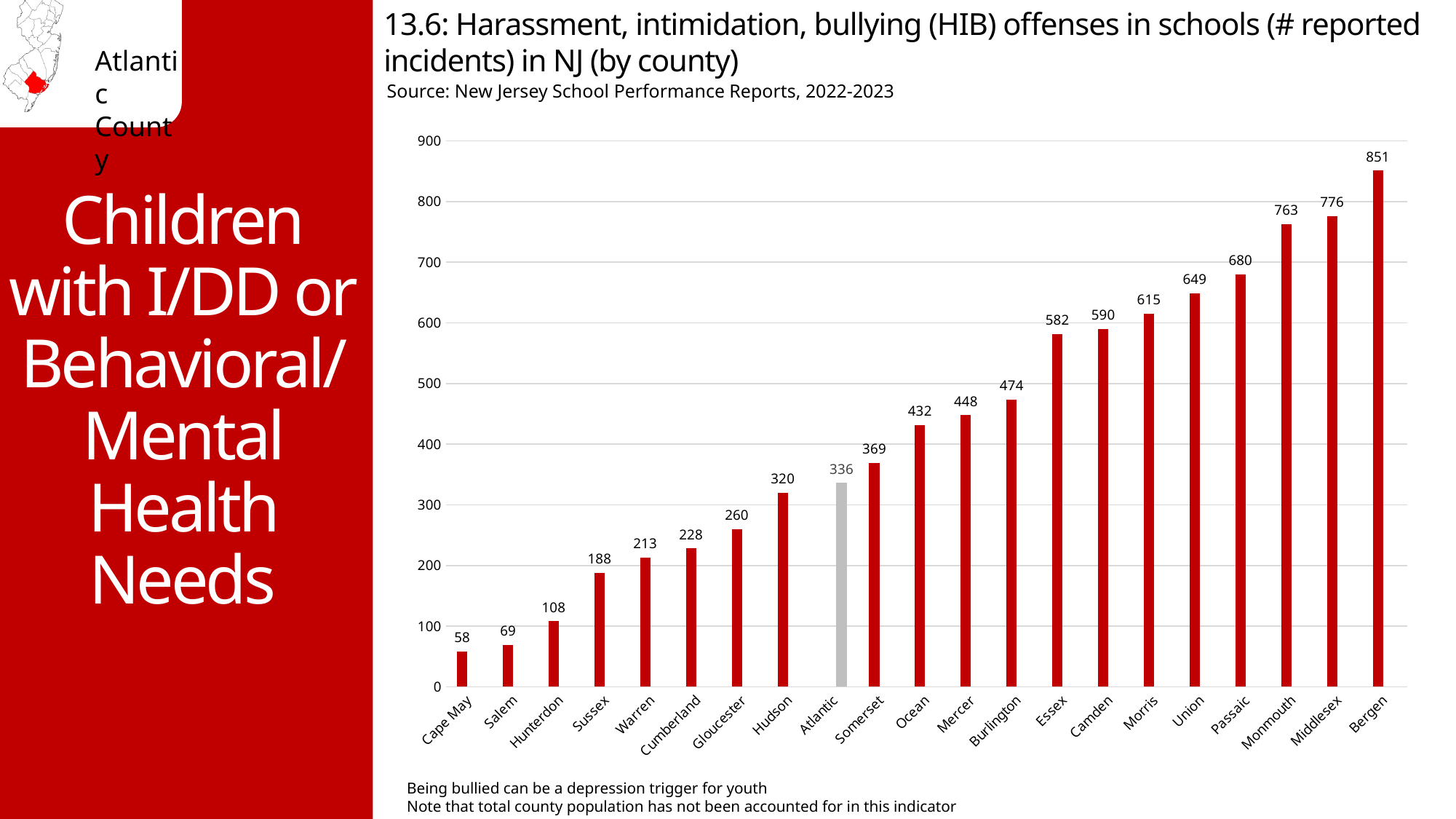
What is the number of reported HIB incidents for Hudson County? 320 Which county has the lowest number of reported HIB incidents? Cape May What is the number of reported HIB incidents for Atlantic County? 336 Which county has more reported HIB incidents, Essex or Camden? Camden What is the number of reported HIB incidents for Bergen County? 851 Do the values rise or fall moving from left to right along the x axis? Rise Which county's bar is coloured grey instead of red? Atlantic Which county has the highest number of reported HIB incidents? Bergen How many counties are shown on the chart? 21 What is the difference in reported HIB incidents between Somerset and Atlantic? 33 What kind of chart is shown on the slide? Bar chart What is the difference in reported HIB incidents between Bergen and Cape May? 793